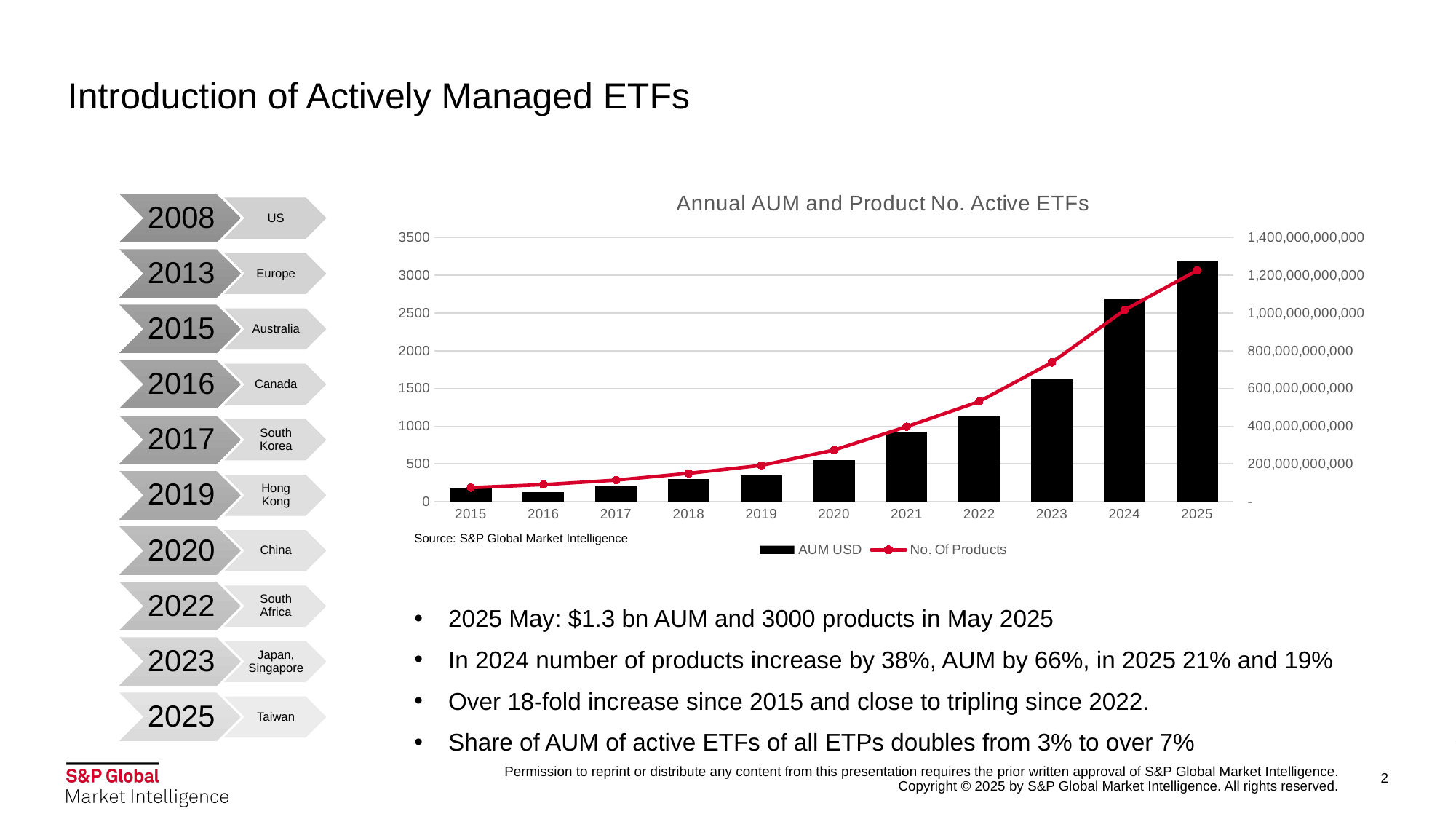
Which year has the highest AUM USD bar? 2025 What type of chart is shown on the slide? Combination bar and line chart Which year has the larger AUM USD bar, 2022 or 2023? 2023 How many years are shown on the x axis of the chart? 11 Does the No. Of Products line rise or fall from 2015 to 2025? Rises Which year has the lowest AUM USD bar? 2016 Is the No. Of Products value for 2015 greater or less than 500? less Is the No. Of Products value for 2023 greater or less than 1500? greater Which year has the lowest value on the No. Of Products line? 2015 Is the AUM USD value for 2025 greater or less than 1,000,000,000,000? greater How many series does the legend list in the 'Annual AUM and Product No. Active ETFs' chart? 2